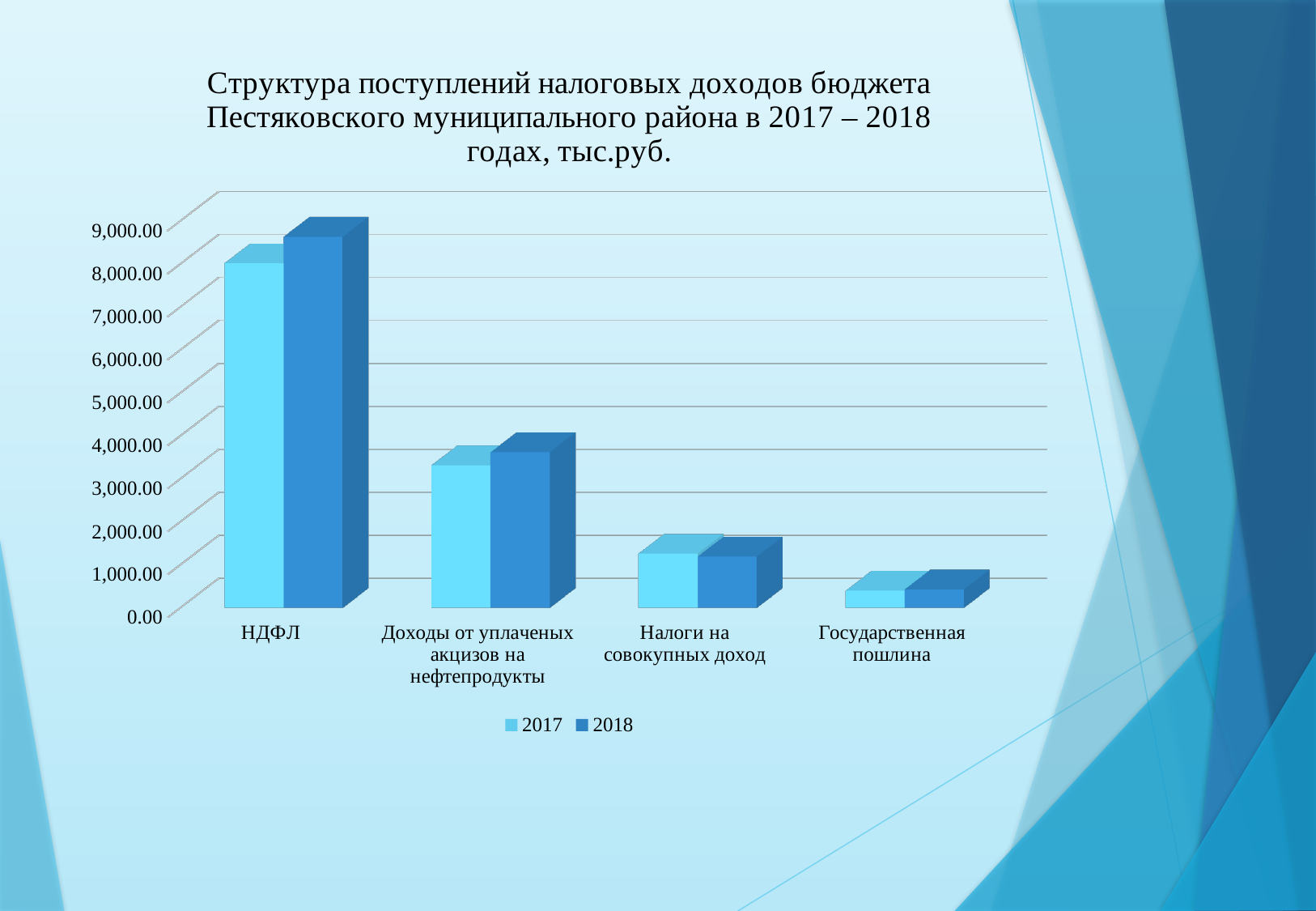
Is the 2017 value for НДФЛ greater or less than 7,000.00? greater Is the 2018 value for НДФЛ greater or less than 8,000.00? greater How many categories are shown on the x axis of the chart? 4 Is the 2017 value for Доходы от уплаченых акцизов на нефтепродукты greater or less than 4,000.00? less For НДФЛ, which year has the larger value, 2017 or 2018? 2018 Which category has the highest value for 2017? НДФЛ What are the two entries listed in the chart legend? 2017 and 2018 How many series does the chart legend list? 2 What kind of chart is shown on the slide? bar chart Which category has the lowest value for 2018? Государственная пошлина